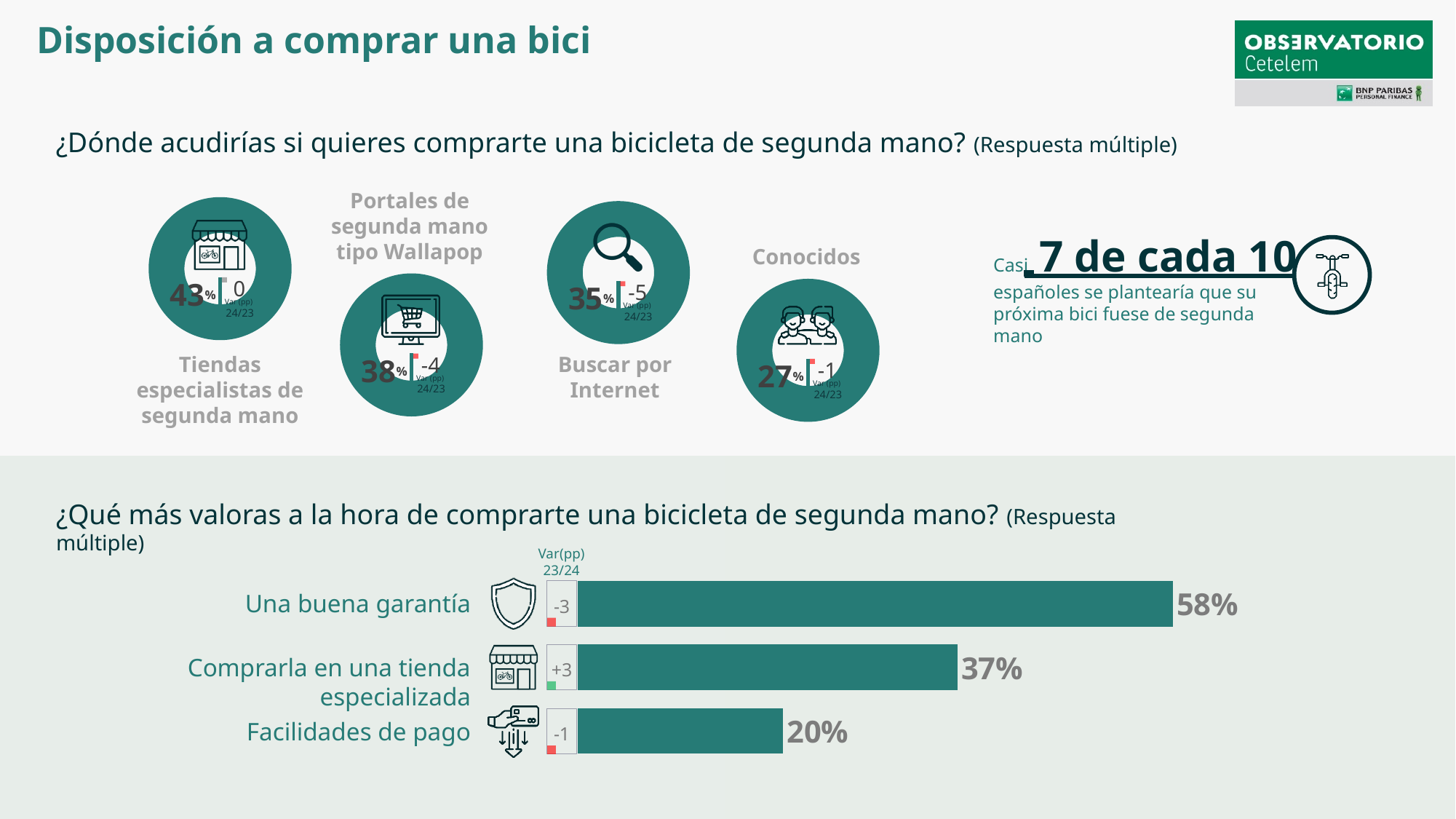
In the top chart (¿Dónde acudirías si quieres comprarte una bicicleta de segunda mano?), what is the value for 'Conocidos'? 27% In the bottom chart (¿Qué más valoras a la hora de comprarte una bicicleta de segunda mano?), what is the value for 'Facilidades de pago'? 20% In the top chart (¿Dónde acudirías si quieres comprarte una bicicleta de segunda mano?), what is the Var(pp) 24/23 shown for 'Buscar por Internet'? -5 In the bottom chart (¿Qué más valoras a la hora de comprarte una bicicleta de segunda mano?), how many categories are shown? 3 What kind of chart is the bottom chart (¿Qué más valoras a la hora de comprarte una bicicleta de segunda mano?)? Bar chart In the bottom chart (¿Qué más valoras a la hora de comprarte una bicicleta de segunda mano?), what is the value for 'Una buena garantía'? 58% In the bottom chart (¿Qué más valoras a la hora de comprarte una bicicleta de segunda mano?), which category has the highest value? Una buena garantía In the bottom chart (¿Qué más valoras a la hora de comprarte una bicicleta de segunda mano?), what is the Var(pp) 23/24 shown for 'Comprarla en una tienda especializada'? +3 In the top chart (¿Dónde acudirías si quieres comprarte una bicicleta de segunda mano?), which is larger: 'Portales de segunda mano tipo Wallapop' or 'Buscar por Internet'? Portales de segunda mano tipo Wallapop In the top chart (¿Dónde acudirías si quieres comprarte una bicicleta de segunda mano?), what is the value for 'Tiendas especialistas de segunda mano'? 43% In the bottom chart (¿Qué más valoras a la hora de comprarte una bicicleta de segunda mano?), which category has the lowest value? Facilidades de pago In the bottom chart (¿Qué más valoras a la hora de comprarte una bicicleta de segunda mano?), what is the difference between 'Una buena garantía' and 'Comprarla en una tienda especializada'? 21%